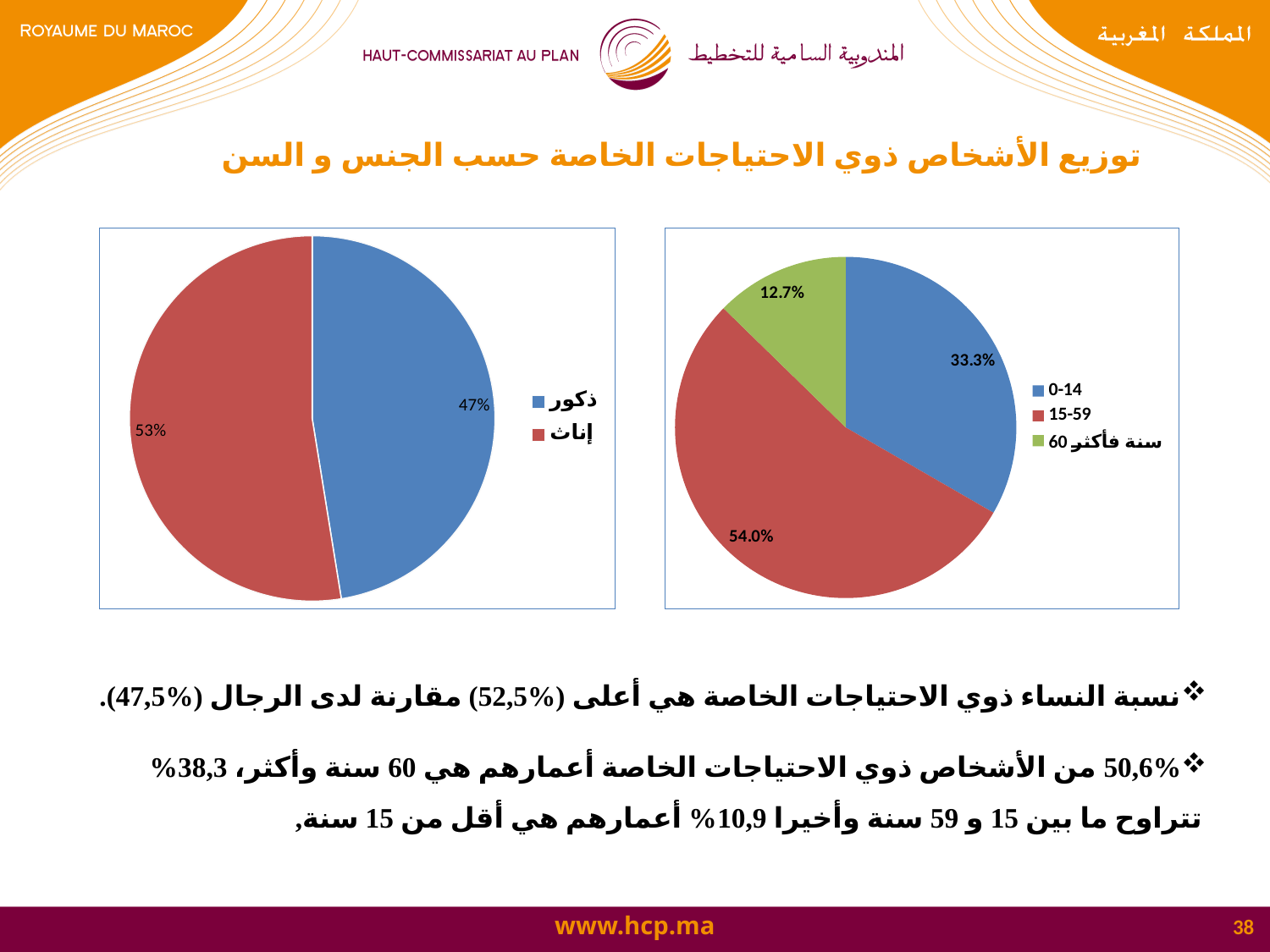
In the right pie chart, what share is shown for 60 سنة فأكثر? 12.7% What kind of chart is the left chart on the slide? pie chart In the right pie chart, which age group has the smallest share? 60 سنة فأكثر How many slices does the right pie chart have? 3 How many entries does the legend of the left pie chart list? 2 In the right pie chart, which age group has the largest share? 15-59 In the right pie chart, what share is shown for the 15-59 age group? 54.0% In the right pie chart, what share is shown for the 0-14 age group? 33.3% In the left pie chart, which category has the larger share, ذكور or إناث? إناث In the left pie chart, what share is shown for إناث? 53% In the left pie chart, what share is shown for ذكور? 47% In the left pie chart, what is the difference between the shares of إناث and ذكور? 6%